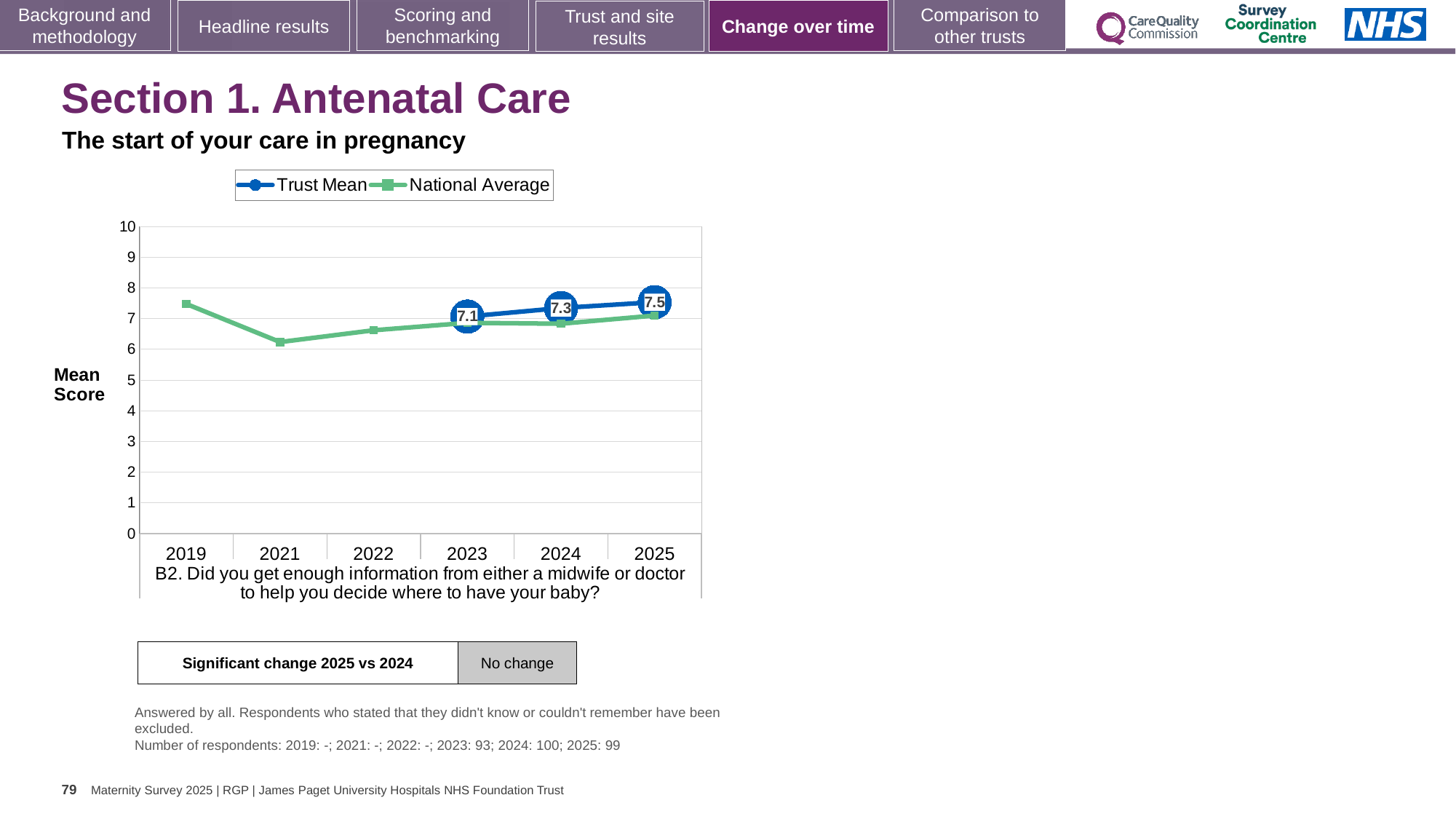
Is the National Average value for 2021 greater or less than 7? less What is the Trust Mean score for 2025? 7.5 What is the Trust Mean score for 2023? 7.1 Is the National Average value for 2019 greater or less than 7? greater What kind of chart is shown on the slide? line chart What is the Trust Mean score for 2024? 7.3 How many years are shown on the x axis? 6 How many series does the legend list? 2 By how much did the Trust Mean score increase from 2023 to 2025? 0.4 Does the Trust Mean rise or fall from 2023 to 2025? rises In which year is the Trust Mean score lowest among the labelled years? 2023 In which year is the Trust Mean score highest? 2025